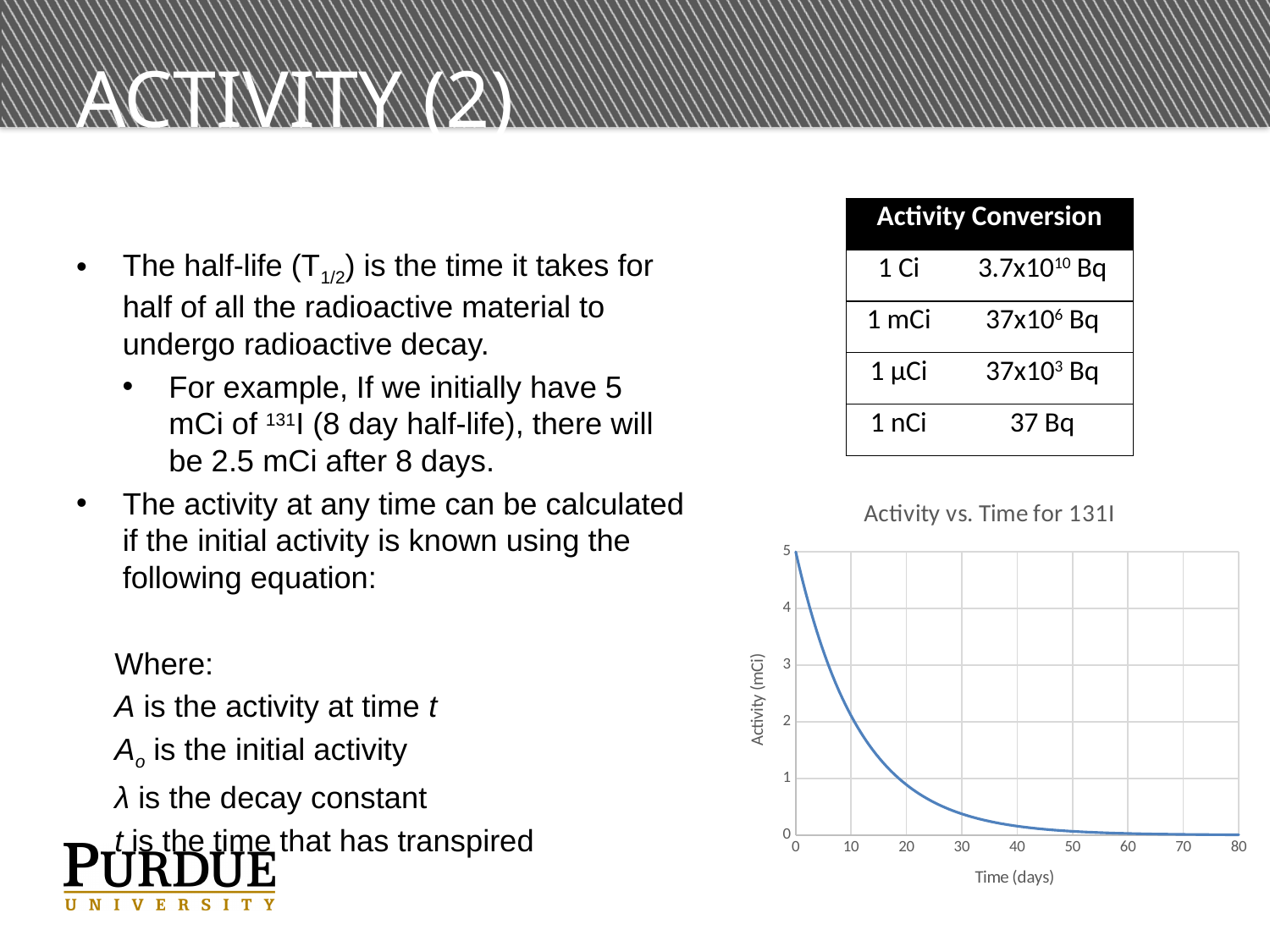
At what time on the x axis is the activity highest? 0 Is the activity at 10 days greater or less than 4? less Is the activity at 10 days greater or less than 1? greater At what time on the x axis is the activity lowest? 80 What is the title of the chart? Activity vs. Time for 131I What kind of chart is shown on the slide? line chart Is the activity at 40 days greater or less than 1? less Do the values on the chart rise or fall as time increases along the x axis? fall What is the activity shown on the chart at time 0 days? 5 Which is larger, the activity at 10 days or the activity at 30 days? 10 days What is the label of the y axis of the chart? Activity (mCi)